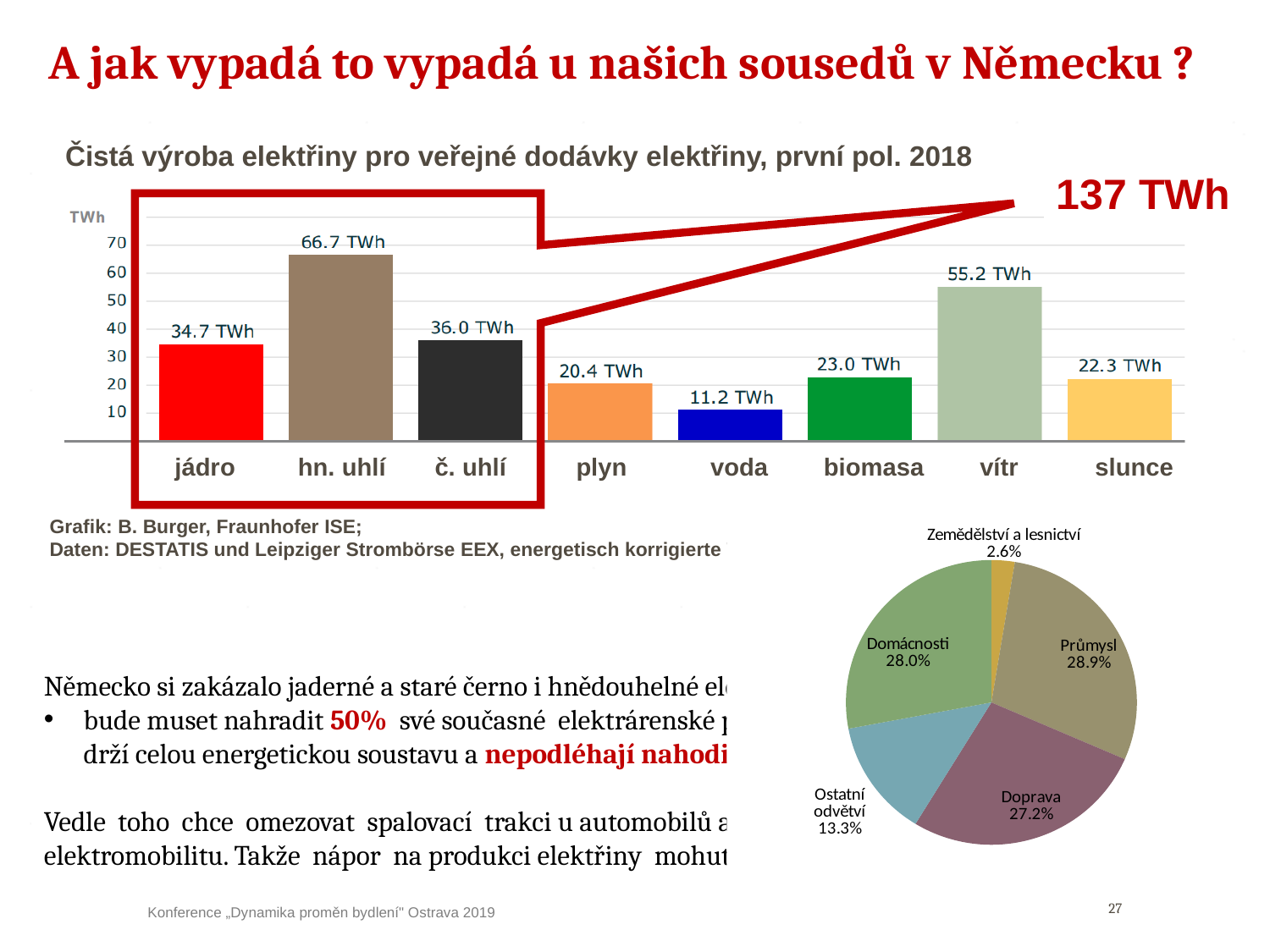
In the bar chart, what is the value for voda? 11.2 TWh In the bar chart, which category has the lowest value? voda In the bar chart, which is larger, the value for plyn or the value for biomasa? biomasa In the pie chart, which slice is the smallest? Zemědělství a lesnictví How many slices does the pie chart have? 5 In the bar chart, what is the difference between the values for hn. uhlí and jádro? 32.0 TWh In the pie chart, what share does Doprava have? 27.2% In the bar chart, which category has the highest value? hn. uhlí In the bar chart, what is the value for hn. uhlí? 66.7 TWh In the bar chart, what is the value for vítr? 55.2 TWh How many categories does the bar chart show? 8 What kind of chart is the chart at the top of the slide? bar chart